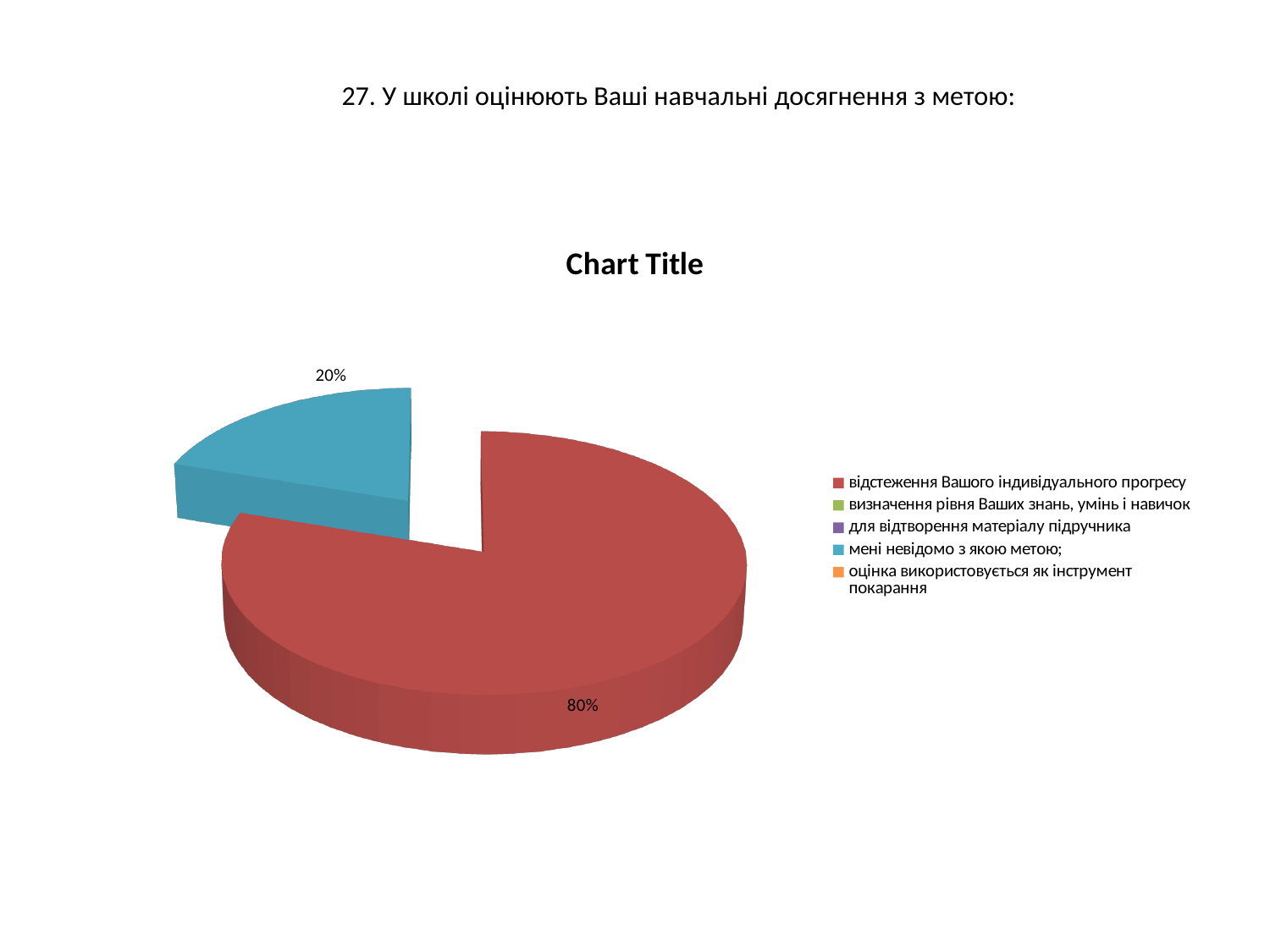
What is the title printed above the pie chart? Chart Title How many categories does the legend list? 5 What share of the pie does "мені невідомо з якою метою;" have? 20% Which is larger: the share for "відстеження Вашого індивідуального прогресу" or the share for "мені невідомо з якою метою;"? відстеження Вашого індивідуального прогресу What share of the pie does "відстеження Вашого індивідуального прогресу" have? 80% Which category has the largest slice of the pie? відстеження Вашого індивідуального прогресу How many slices with data labels are visible in the pie? 2 What is the difference in percentage points between the 80% slice and the 20% slice? 60 What kind of chart is shown on the slide? pie chart Which of the two visible slices is smaller? мені невідомо з якою метою; What colour is the slice labelled 20%? blue